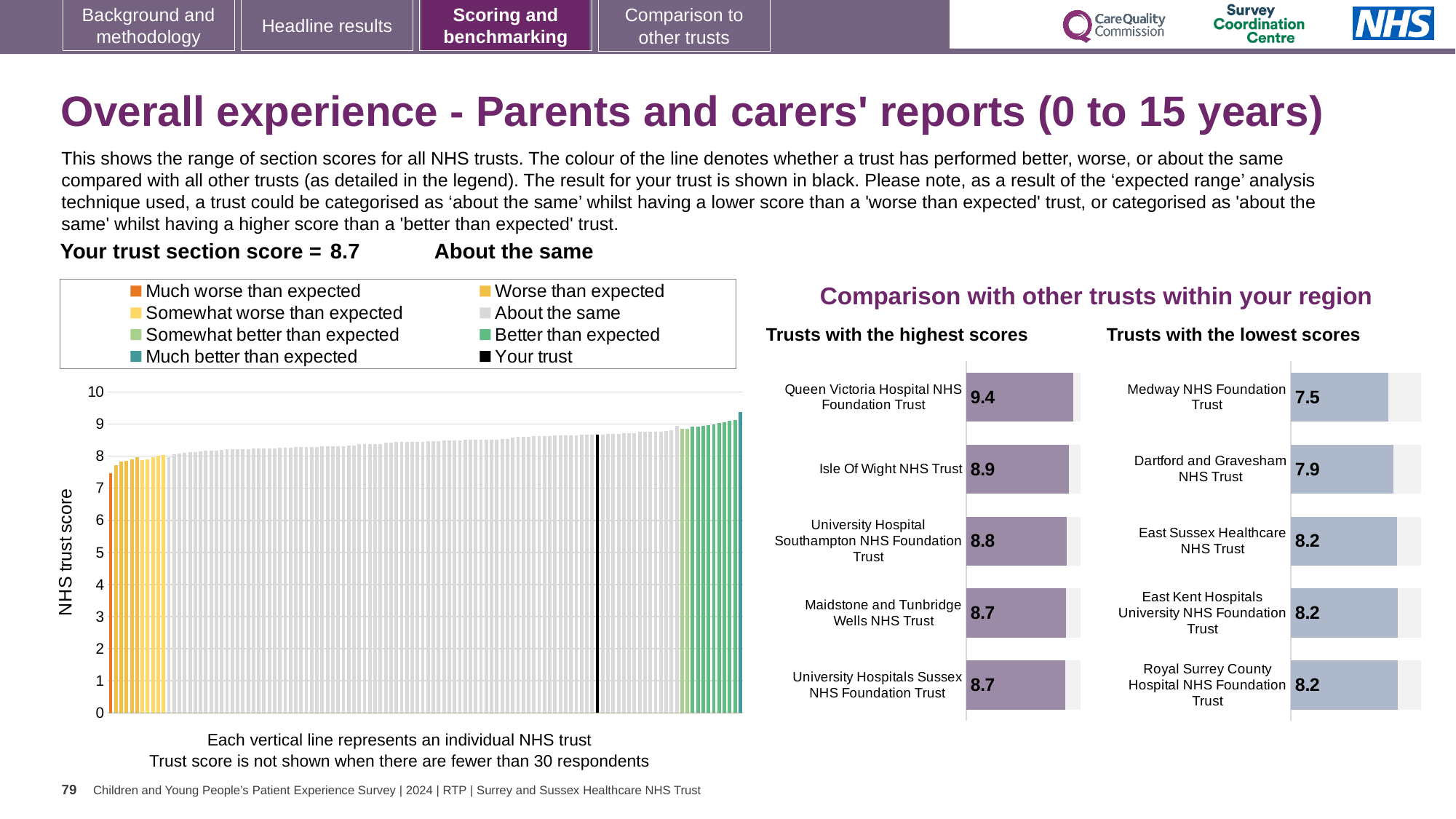
How many trusts are shown in the 'Trusts with the lowest scores' chart? 5 In the main chart on the left showing all NHS trusts, what is the section score for your trust (the black line)? 8.7 In the 'Trusts with the highest scores' chart, which trust has the highest score? Queen Victoria Hospital NHS Foundation Trust In the 'Trusts with the highest scores' chart, what is the score for University Hospital Southampton NHS Foundation Trust? 8.8 In the 'Trusts with the lowest scores' chart, what is the score for Dartford and Gravesham NHS Trust? 7.9 In the 'Trusts with the lowest scores' chart, what is the score for Medway NHS Foundation Trust? 7.5 In the 'Trusts with the highest scores' chart, which has a higher score: Isle Of Wight NHS Trust or Maidstone and Tunbridge Wells NHS Trust? Isle Of Wight NHS Trust How many entries does the legend of the main chart on the left list? 8 In the 'Trusts with the lowest scores' chart, which trust has the lowest score? Medway NHS Foundation Trust In the 'Trusts with the highest scores' chart, what is the difference between the scores of Queen Victoria Hospital NHS Foundation Trust and Isle Of Wight NHS Trust? 0.5 In the 'Trusts with the highest scores' chart, what is the score for Queen Victoria Hospital NHS Foundation Trust? 9.4 In the 'Trusts with the lowest scores' chart, what is the difference between the scores of East Sussex Healthcare NHS Trust and Medway NHS Foundation Trust? 0.7